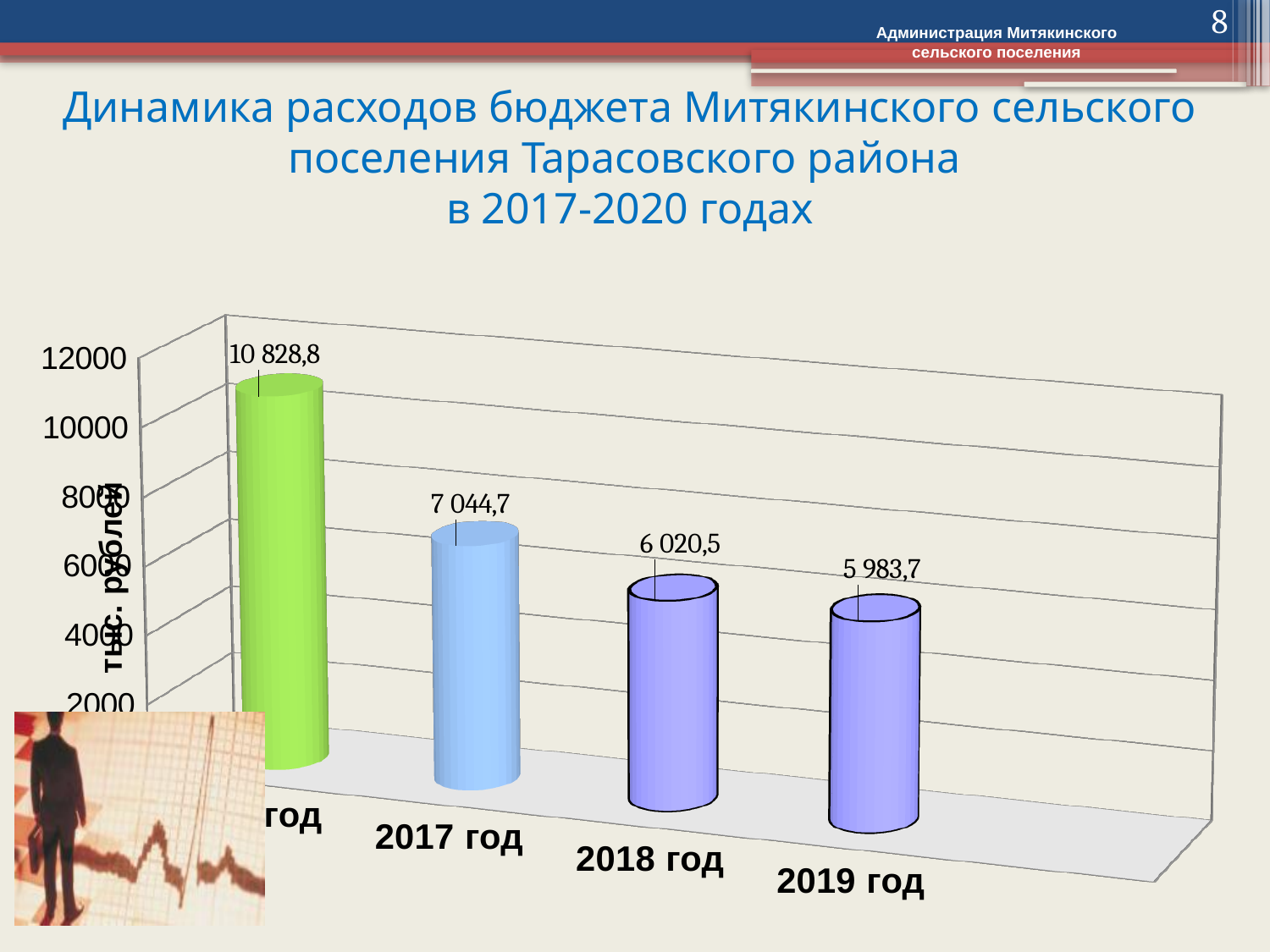
How many bars are plotted in the chart? 4 What is the difference between the leftmost bar's value and the value for 2017 год? 3 784,1 What is the value for 2018 год? 6 020,5 What is the difference between the values for 2018 год and 2019 год? 36,8 Do the values rise or fall from left to right across the chart? fall Which is larger, the value for 2017 год or the value for 2019 год? 2017 год Which of the labelled years has the lowest value? 2019 год What is the value shown on the leftmost (green) bar? 10 828,8 What is the difference between the values for 2017 год and 2018 год? 1 024,2 What kind of chart is shown on the slide? bar chart What is the value for 2017 год? 7 044,7 What is the value for 2019 год? 5 983,7